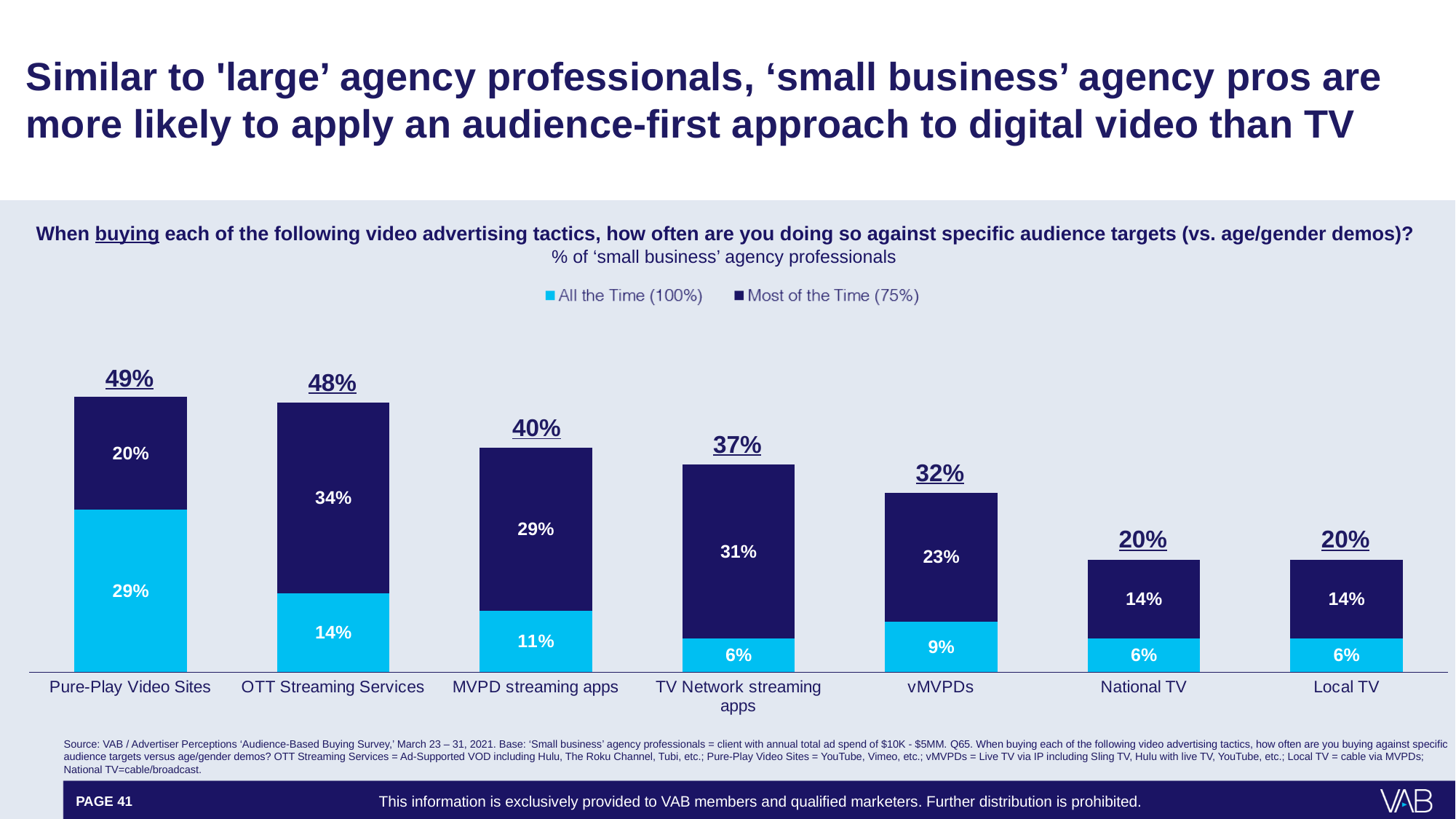
Which category has the highest 'Most of the Time (75%)' value? OTT Streaming Services How many categories are shown on the x axis? 7 What is the difference between the totals for Pure-Play Video Sites and Local TV? 29% What is the 'All the Time (100%)' value for vMVPDs? 9% How many series does the legend list? 2 What kind of chart is shown on the slide? Stacked bar chart Which category has the highest total? Pure-Play Video Sites What is the 'Most of the Time (75%)' value for OTT Streaming Services? 34% What is the 'All the Time (100%)' value for Pure-Play Video Sites? 29% Do the bar totals rise or fall from left to right along the x axis? Fall What is the total shown above the bar for MVPD streaming apps? 40% Which is larger: the 'All the Time (100%)' value for OTT Streaming Services or for MVPD streaming apps? OTT Streaming Services